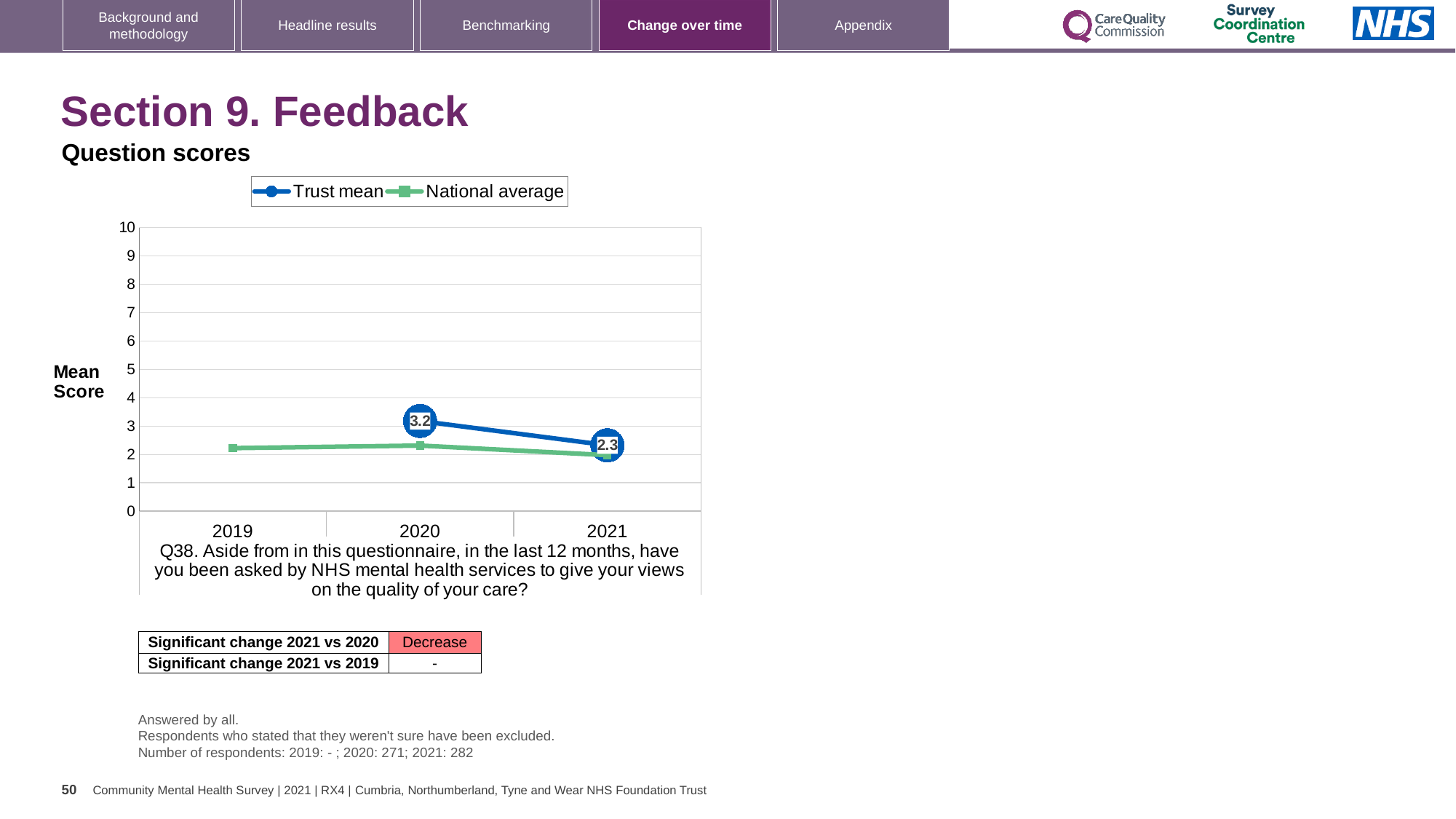
In 2020, which series has the higher value, Trust mean or National average? Trust mean Which year has the higher Trust mean score, 2020 or 2021? 2020 How many years are shown on the x axis of the chart? 3 By how much did the Trust mean score change between 2020 and 2021? 0.9 Is the National average value for 2019 greater or less than 3? less What is the label on the y axis of the chart? Mean Score What type of chart is shown on the slide? line chart What is the Trust mean score for 2021? 2.3 What is the Trust mean score for 2020? 3.2 Is the National average value for 2021 greater or less than 3? less How many series does the chart legend list? 2 Does the Trust mean rise or fall from 2020 to 2021? fall